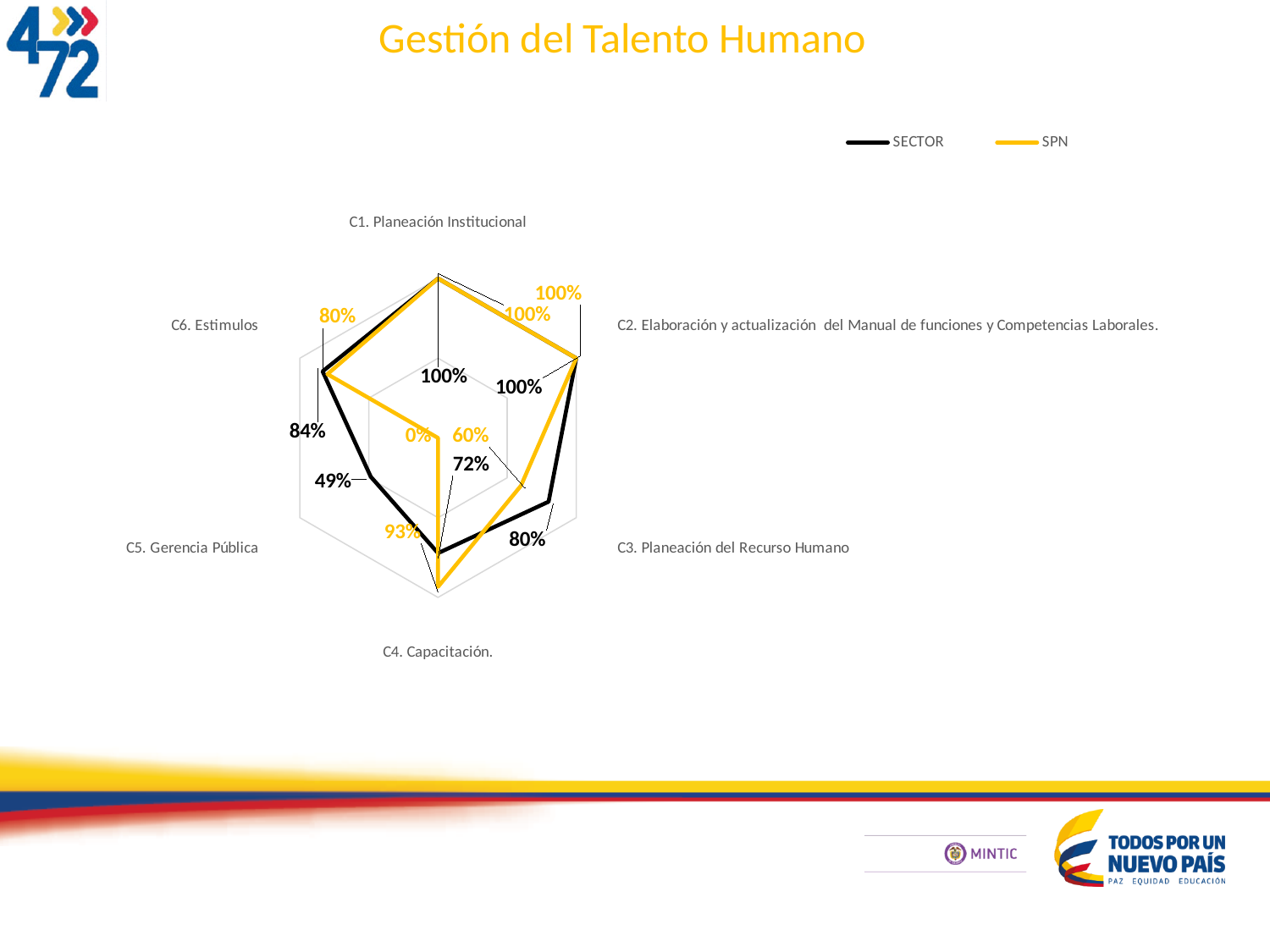
What is the SECTOR value for C6. Estimulos? 84% How many series does the legend list? 2 What colour is the SPN series line? Yellow Which category has the lowest SECTOR value? C5. Gerencia Pública What kind of chart is shown on the slide? Radar chart For C3. Planeación del Recurso Humano, which series has the larger value, SECTOR or SPN? SECTOR What is the SECTOR value for C5. Gerencia Pública? 49% What is the SPN value for C5. Gerencia Pública? 0% What is the difference between the SPN and SECTOR values for C4. Capacitación? 21 percentage points What is the SPN value for C4. Capacitación? 93% How many categories (axes) does the radar chart have? 6 What is the SECTOR value for C3. Planeación del Recurso Humano? 80%